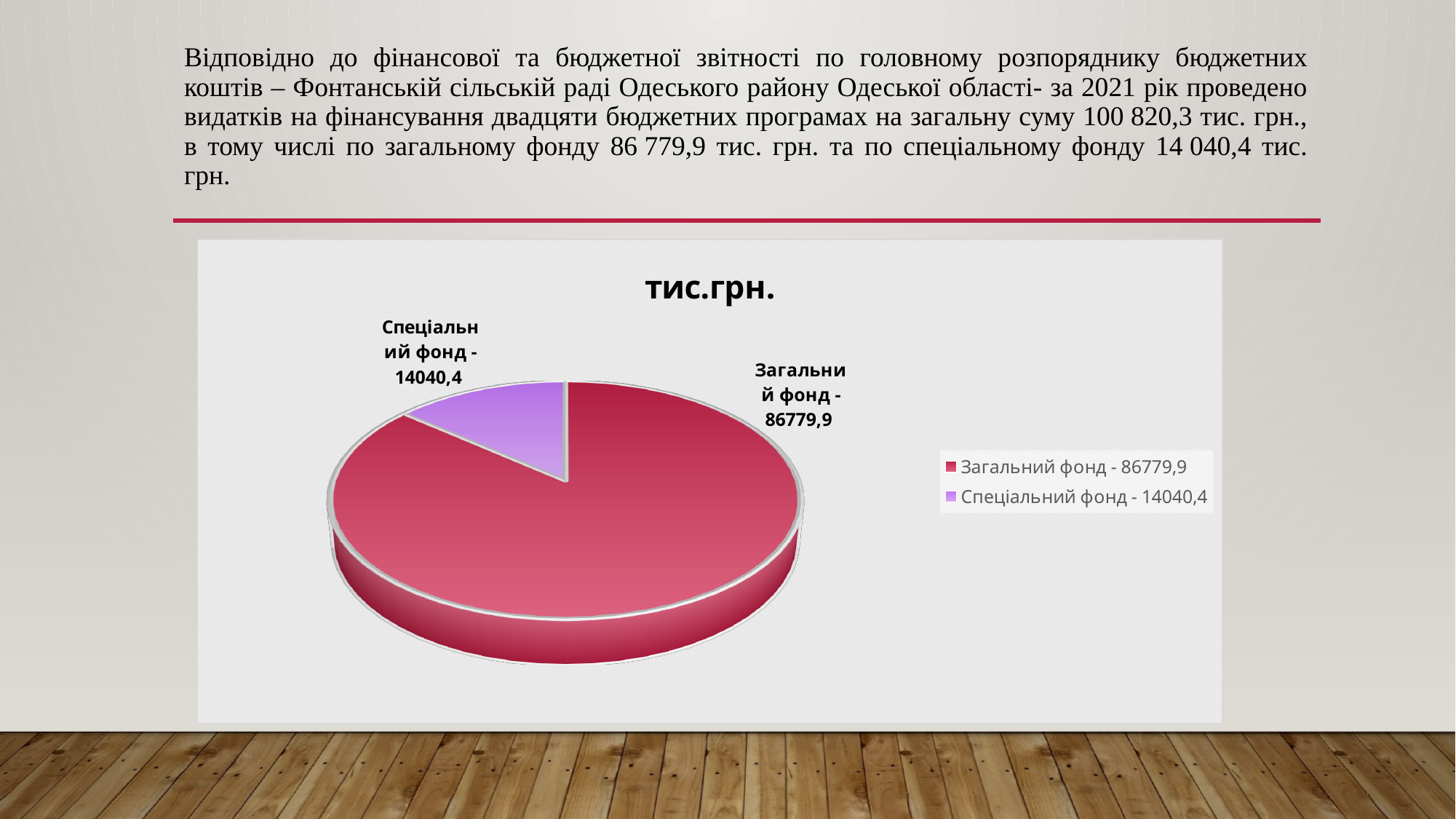
What is the total of the two values shown in the pie chart? 100820,3 How many slices does the pie chart have? 2 What colour is the slice for Спеціальний фонд? Purple What is the value shown for Загальний фонд? 86779,9 What is the difference between the values for Загальний фонд and Спеціальний фонд? 72739,5 Which slice of the pie chart is the smallest? Спеціальний фонд Which slice of the pie chart is the largest? Загальний фонд Which is larger, Загальний фонд or Спеціальний фонд? Загальний фонд What is the value shown for Спеціальний фонд? 14040,4 What kind of chart is shown on the slide? Pie chart What is the title of the chart? тис.грн. How many entries does the chart legend list? 2